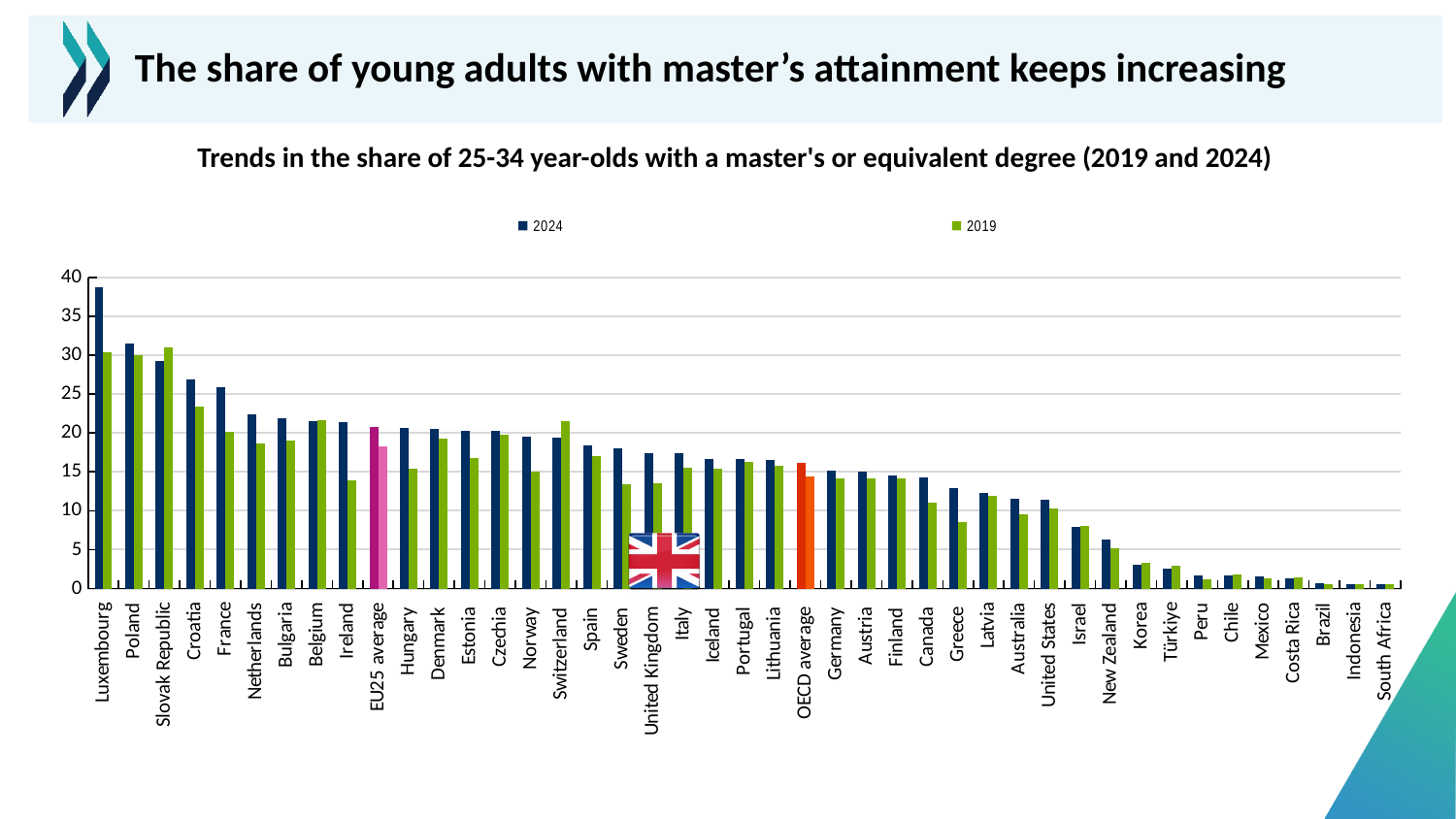
Is the 2024 value for Croatia greater or less than 25? greater Which country has the highest 2024 value? Luxembourg What are the two entries in the legend? 2024 and 2019 Do the 2024 values generally rise or fall moving from left to right along the x axis? Fall How many countries or averages are shown along the x axis? 43 Which is larger: the 2024 value for Luxembourg or the 2024 value for Poland? Luxembourg What kind of chart is shown on the slide? Bar chart How many series does the legend list? 2 Is the 2019 value for Ireland greater or less than 15? less For Switzerland, which is larger: the 2019 value or the 2024 value? 2019 Is the 2019 value for Switzerland greater or less than 20? greater